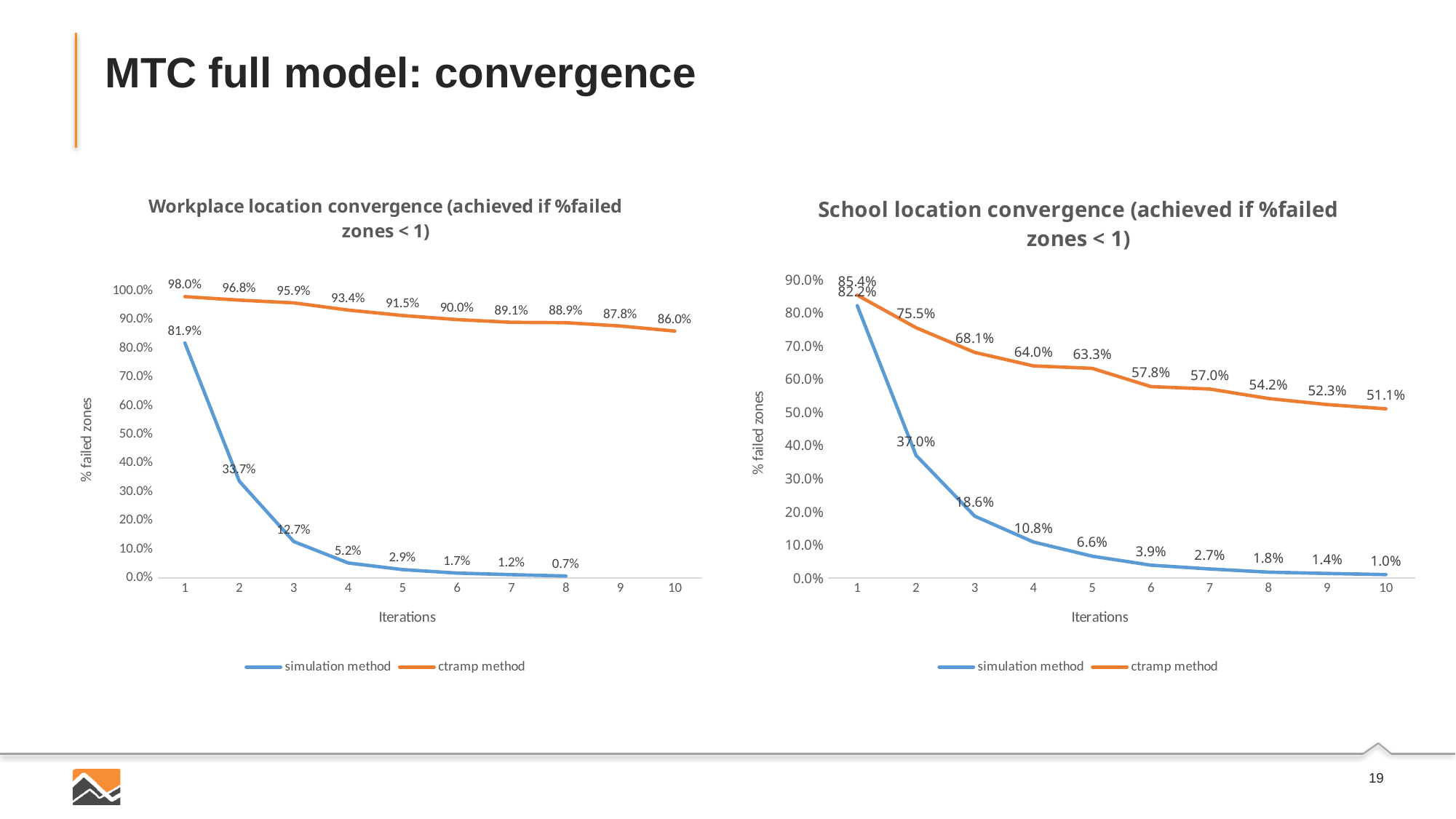
What kind of chart is the School location convergence chart? Line chart In the Workplace location convergence chart, which method has the higher value at iteration 5? ctramp method How many series does the legend of the School location convergence chart list? 2 In the School location convergence chart, what is the value for the ctramp method at iteration 10? 51.1% In the Workplace location convergence chart, does the ctramp method rise or fall as iterations increase? Fall In the Workplace location convergence chart, what is the difference between the ctramp method and the simulation method at iteration 1? 16.1% In the School location convergence chart, what is the difference between the ctramp method values at iteration 1 and iteration 10? 34.3% In the Workplace location convergence chart, what is the value for the ctramp method at iteration 1? 98.0% In the School location convergence chart, what is the value for the simulation method at iteration 2? 37.0% In the Workplace location convergence chart, how many data points are plotted for the simulation method? 8 In the Workplace location convergence chart, what is the value for the simulation method at iteration 3? 12.7% In the School location convergence chart, at which iteration is the simulation method lowest? 10